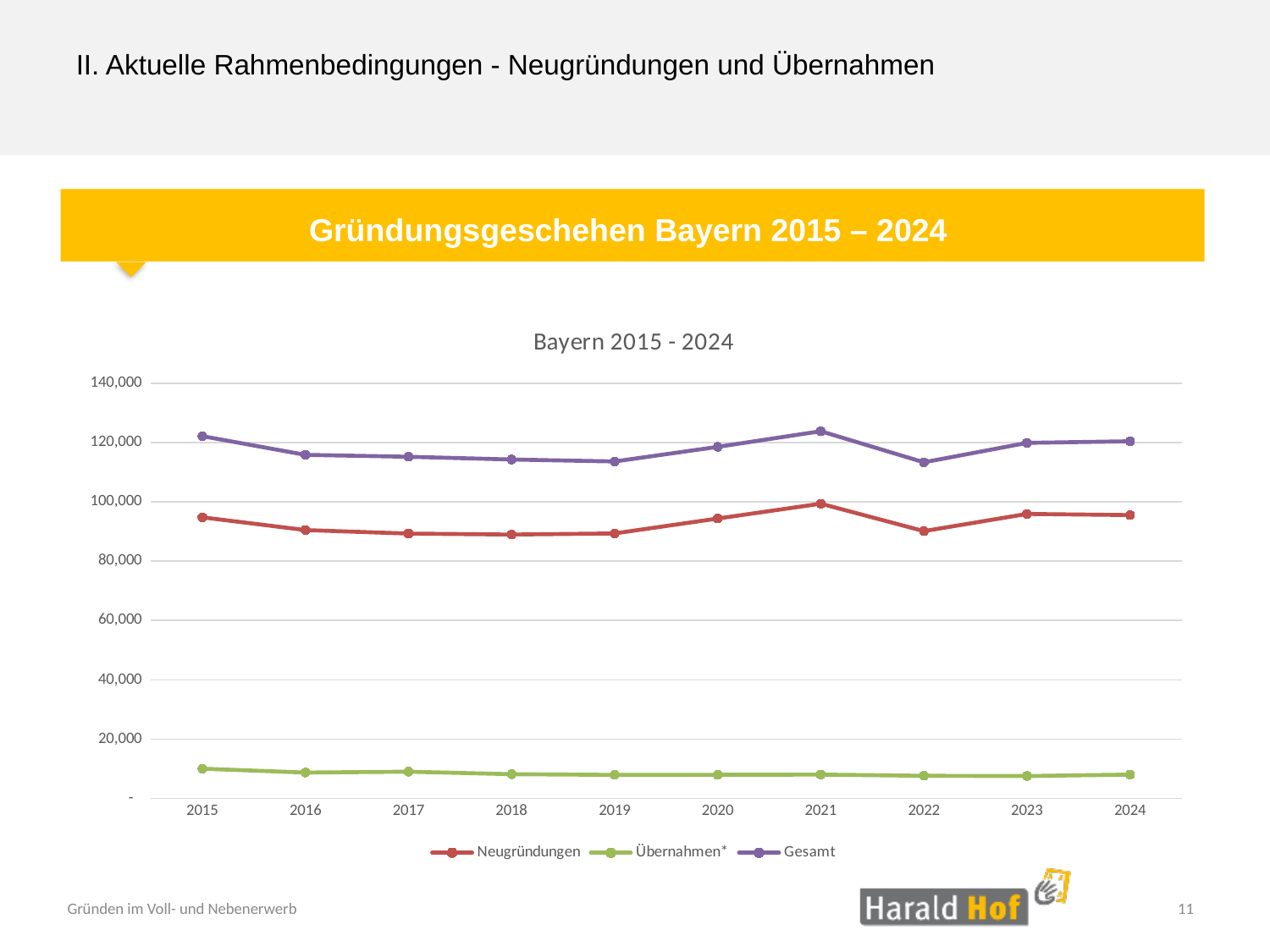
In which year does the Gesamt series reach its highest value? 2021 In which year does the Neugründungen series reach its highest value? 2021 In which year is the Übernahmen* series at its highest? 2015 Which is larger, the Neugründungen value for 2021 or for 2022? 2021 What kind of chart is shown on the slide? Line chart Does the Übernahmen* series rise or fall from 2015 to 2024? fall How many series does the chart legend list? 3 How many years are plotted along the x axis? 10 Is the Gesamt value for 2021 greater or less than 120,000? greater What is the title shown above the chart's plot area? Bayern 2015 - 2024 Is the Übernahmen* value for 2015 greater or less than 20,000? less